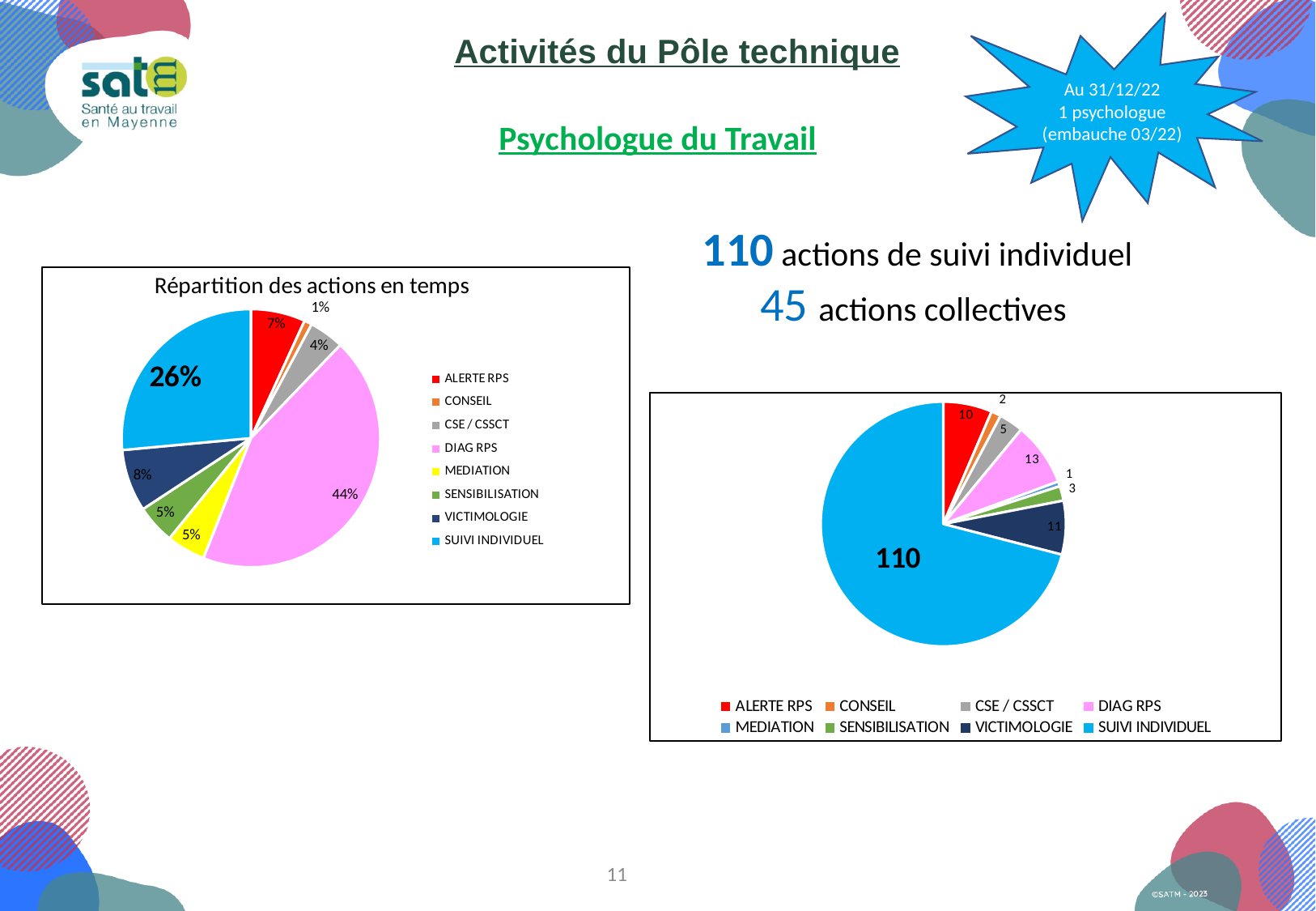
In the pie chart titled 'Répartition des actions en temps', which category has the largest share? DIAG RPS In the pie chart titled 'Répartition des actions en temps', what share is shown for SUIVI INDIVIDUEL? 26% In the pie chart on the right of the slide, which is larger, ALERTE RPS or CSE / CSSCT? ALERTE RPS In the pie chart on the right of the slide, what value is shown for VICTIMOLOGIE? 11 In the pie chart titled 'Répartition des actions en temps', what is the difference in percentage points between DIAG RPS and SUIVI INDIVIDUEL? 18 In the pie chart on the right of the slide, what value is shown for SUIVI INDIVIDUEL? 110 In the pie chart titled 'Répartition des actions en temps', what share is shown for VICTIMOLOGIE? 8% How many categories does the legend of the pie chart on the right of the slide list? 8 What type of chart is the chart titled 'Répartition des actions en temps'? Pie chart In the pie chart on the right of the slide, what value is shown for DIAG RPS? 13 In the pie chart titled 'Répartition des actions en temps', which category has the smallest share? CONSEIL In the pie chart titled 'Répartition des actions en temps', what share is shown for DIAG RPS? 44%